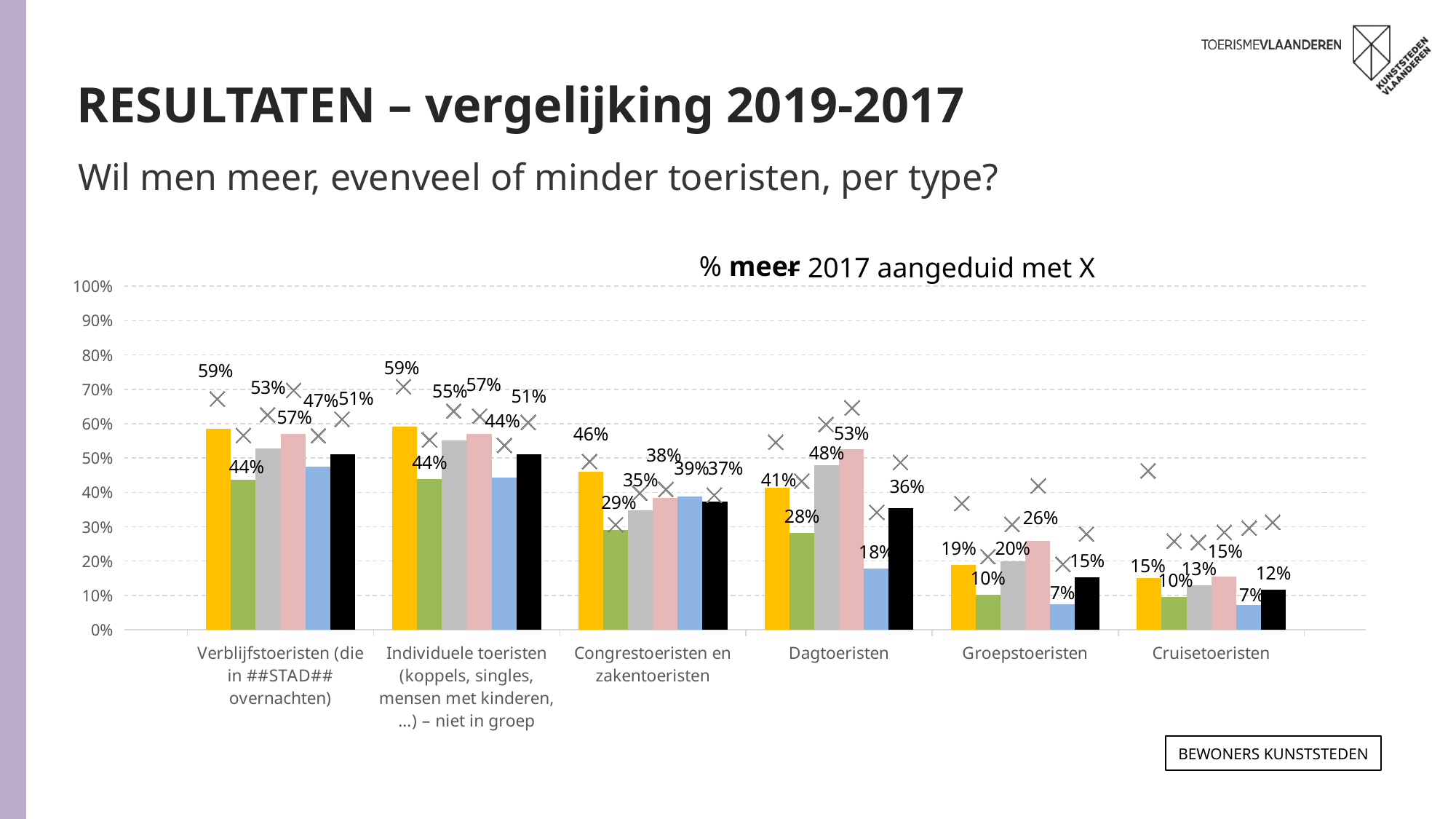
What kind of chart is shown on the slide? bar chart Which is larger for Individuele toeristen: the grey bar or the pink bar? the pink bar (57%) How many tourist-type categories are shown along the x axis? 6 What is the difference between the pink bar (53%) and the blue bar (18%) for Dagtoeristen? 35 percentage points Which bar is the lowest within the Groepstoeristen category? the blue bar (7%) What is the value of the black bar for Cruisetoeristen? 12% Is the X marker above the yellow bar for Cruisetoeristen greater or less than 40%? greater What is the value of the yellow bar for Dagtoeristen? 41% Which bar is the highest within the Dagtoeristen category? the pink bar (53%) Do the yellow bar values rise or fall moving from Verblijfstoeristen on the left to Cruisetoeristen on the right? fall What is the value of the green bar for Congrestoeristen en zakentoeristen? 29% According to the annotation on the chart, what symbol marks the 2017 values? X